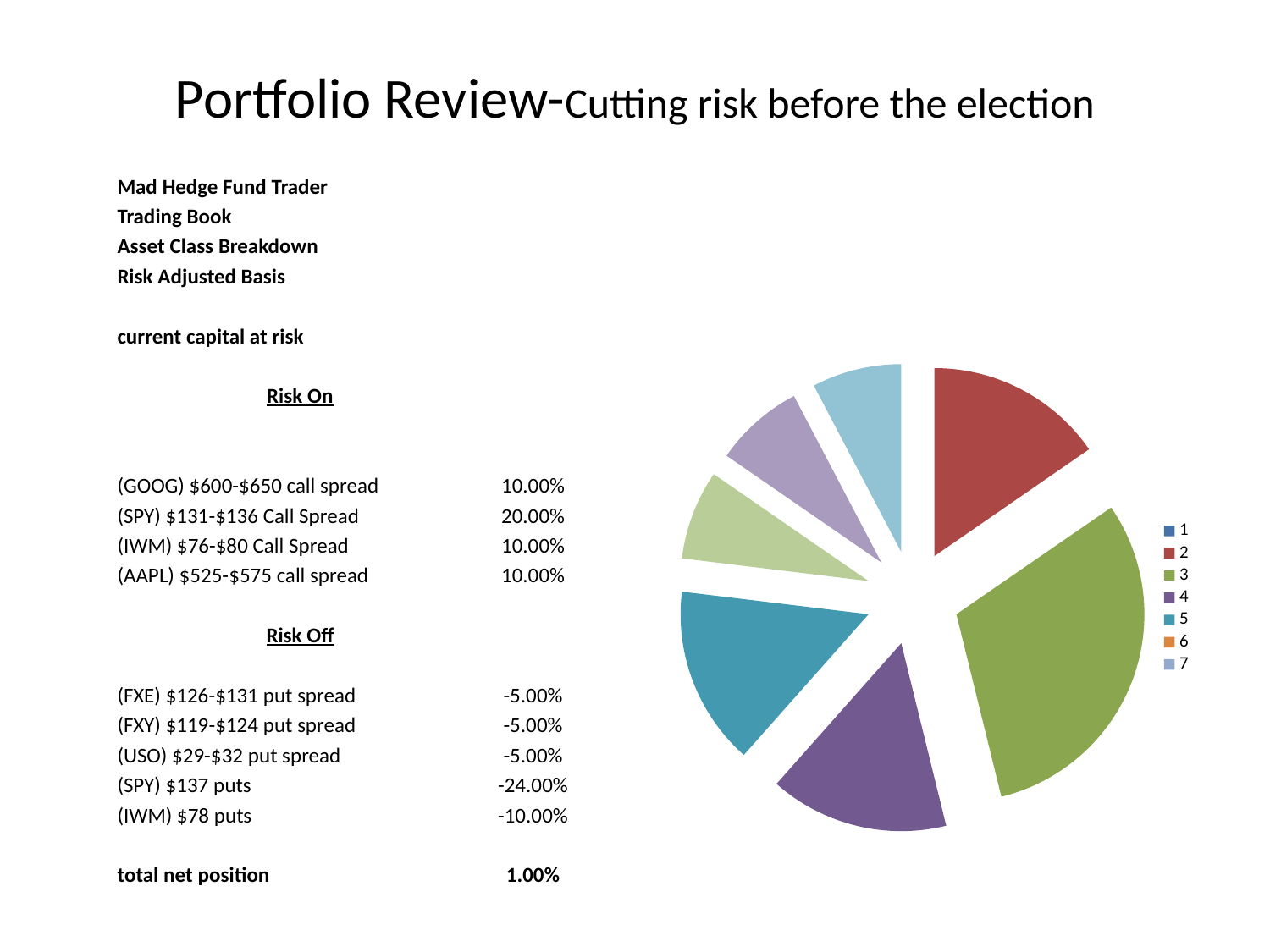
Where is the legend positioned relative to the pie chart? To the right of the pie What kind of chart is shown on the slide? Pie chart How many entries does the pie chart's legend list? 7 What colour is the largest slice of the pie chart? Green Which slice is larger in the pie chart, the green slice (3) or the purple slice (4)? The green slice (3) Which slice is larger in the pie chart, the green slice (3) or the red slice (2)? The green slice (3) Which legend entry corresponds to the largest slice of the pie chart? 3 How many slices does the pie chart show? 7